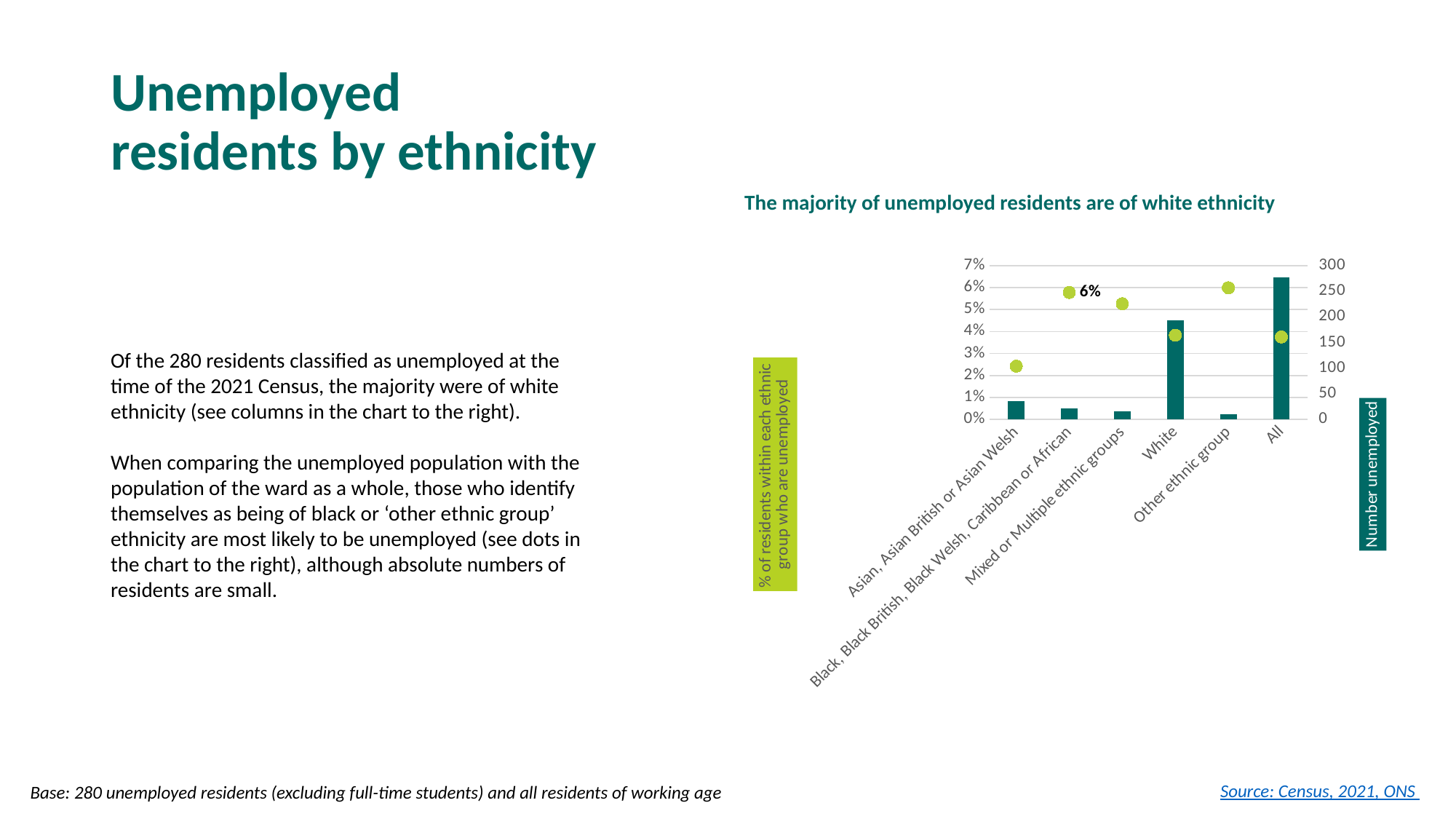
Is the number unemployed for Asian, Asian British or Asian Welsh greater or less than 50? less Which has the higher percentage of residents unemployed (dot): Black, Black British, Black Welsh, Caribbean or African, or Asian, Asian British or Asian Welsh? Black, Black British, Black Welsh, Caribbean or African Is the number unemployed for White greater or less than 150? greater Which ethnic group has the lowest percentage of residents who are unemployed (lowest dot) in the chart? Asian, Asian British or Asian Welsh How many ethnic group categories are shown on the x axis of the chart? 6 Is the number unemployed for All greater or less than 250? greater What percentage of residents in the Black, Black British, Black Welsh, Caribbean or African group are unemployed, according to the data label on the chart? 6% What is the title of the chart? The majority of unemployed residents are of white ethnicity Which has the larger number unemployed (bar): White or Other ethnic group? White Which category has the tallest bar (highest number unemployed) in the chart? All What is the label of the right-hand vertical axis of the chart? Number unemployed